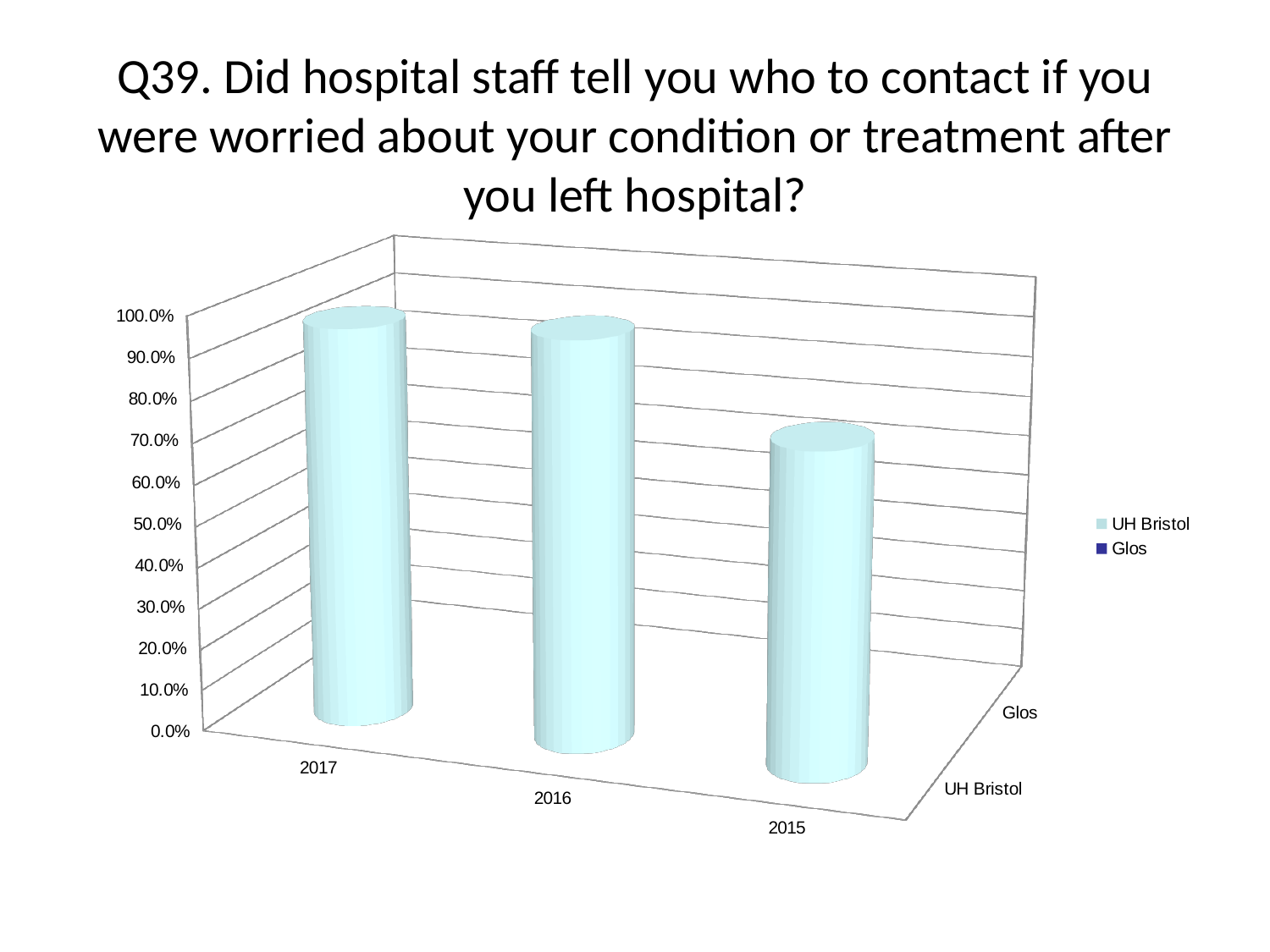
Is the UH Bristol value for 2015 greater or less than 40%? greater What are the two series names listed in the legend? UH Bristol and Glos Which year has the lowest value for UH Bristol? 2015 Which is larger for UH Bristol, the value for 2017 or the value for 2015? 2017 How many year categories are shown on the x axis? 3 Is the UH Bristol value for 2017 greater or less than 70%? greater Is the UH Bristol value for 2016 greater or less than 70%? greater What kind of chart is shown on the slide? bar chart How many series does the legend list? 2 What question number is given in the chart title? Q39